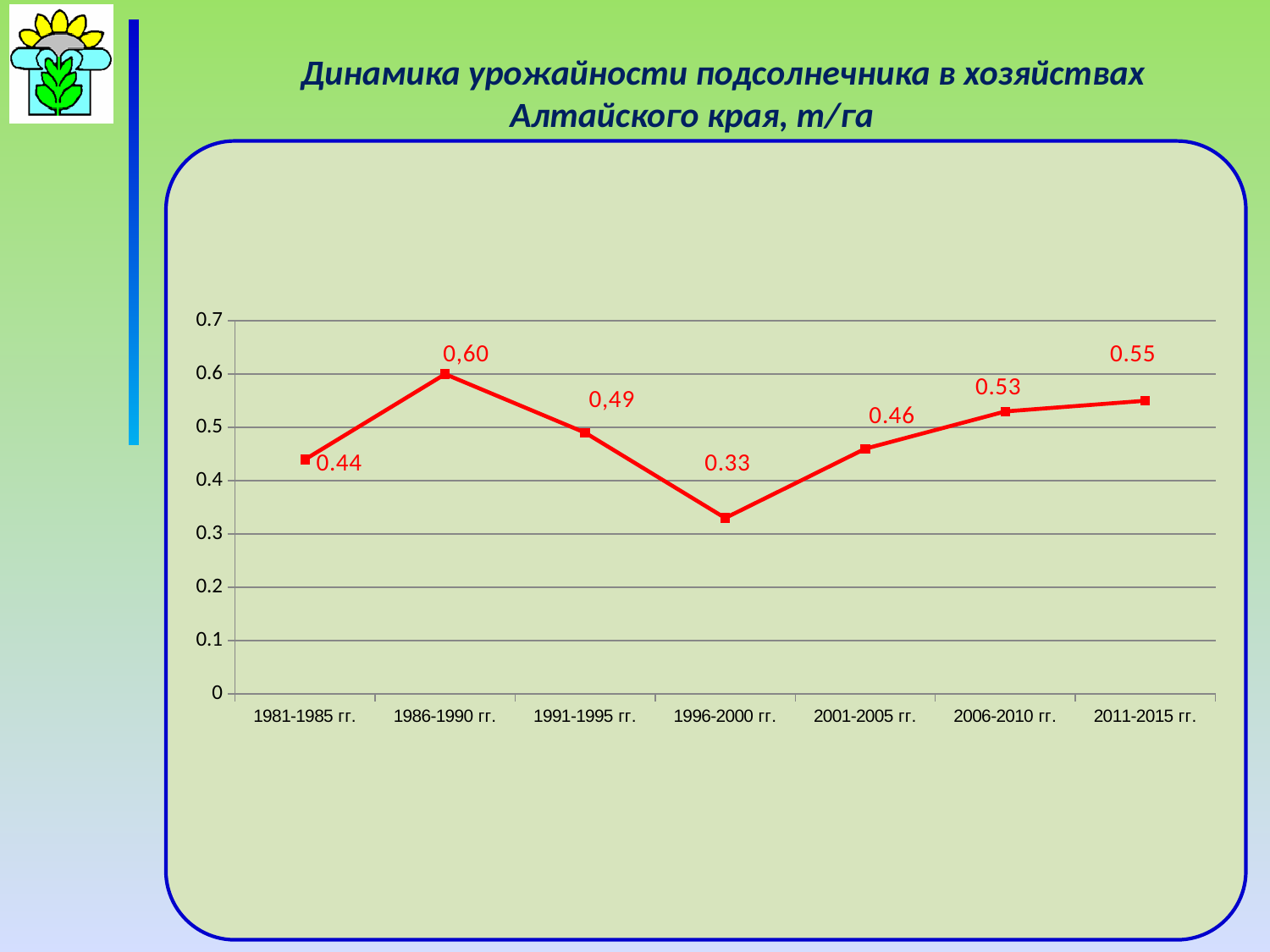
What is the value shown for 2011-2015 гг.? 0.55 What kind of chart is shown on the slide? line chart How many periods are plotted on the x axis? 7 What is the difference between the values for 2006-2010 гг. and 2001-2005 гг.? 0.07 Which period has the highest yield? 1986-1990 гг. Which period has the lowest yield? 1996-2000 гг. What is the value shown for 1986-1990 гг.? 0,60 Do the values rise or fall from 1996-2000 гг. to 2011-2015 гг.? rise What is the sunflower yield for 1981-1985 гг.? 0.44 What is the value shown for 1996-2000 гг.? 0.33 Which is larger, the value for 1991-1995 гг. or the value for 2001-2005 гг.? 1991-1995 гг. Is the value for 1996-2000 гг. greater or less than 0.4? less